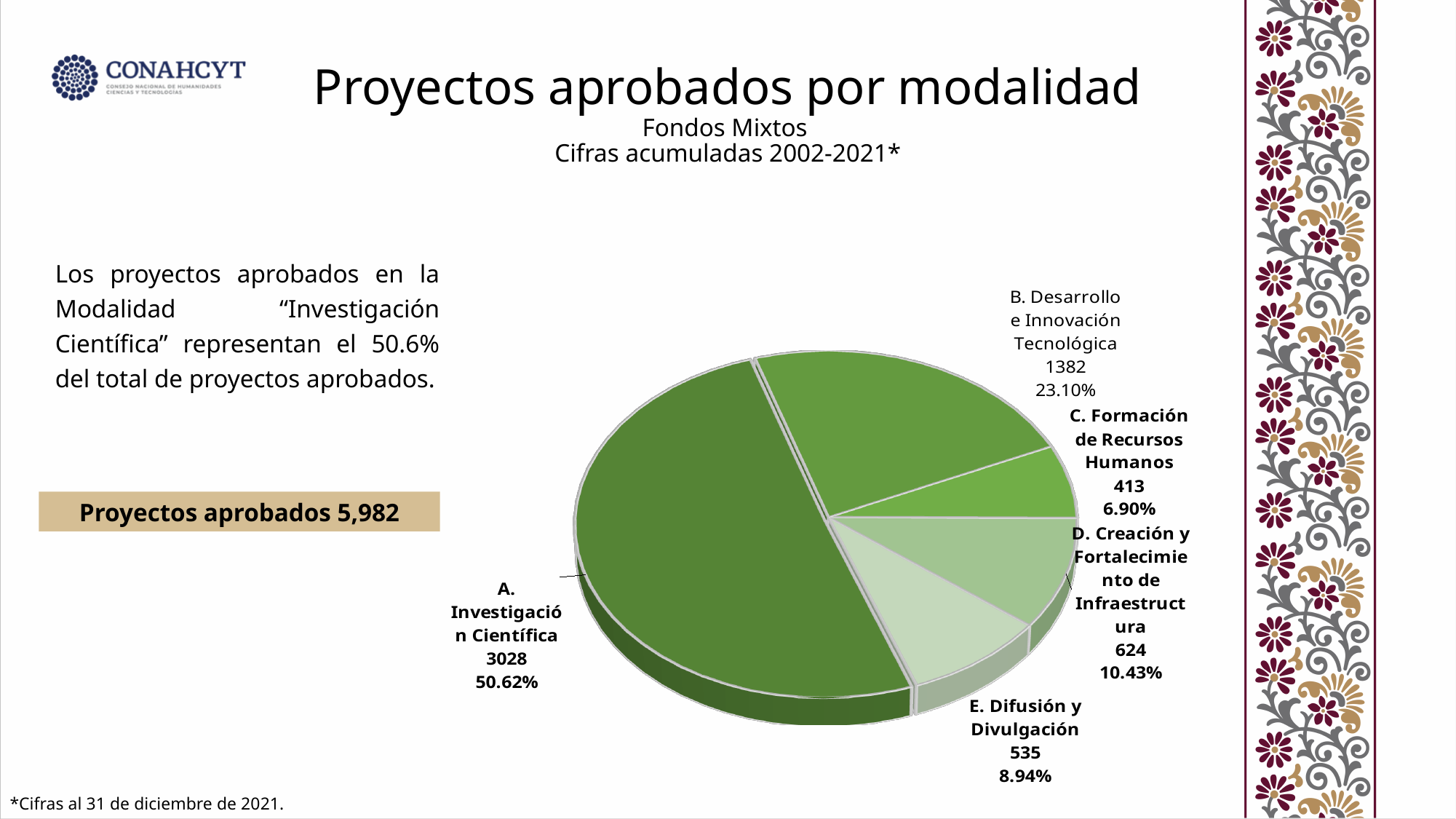
What kind of chart is shown on the slide? Pie chart Which modality has the smallest slice of the pie chart? C. Formación de Recursos Humanos What is the value shown for 'D. Creación y Fortalecimiento de Infraestructura'? 624 Which modality has the largest slice of the pie chart? A. Investigación Científica What percentage share does 'E. Difusión y Divulgación' have? 8.94% What is the title of the chart on the slide? Proyectos aprobados por modalidad What percentage share does 'B. Desarrollo e Innovación Tecnológica' have in the pie chart? 23.10% How many projects were approved in 'C. Formación de Recursos Humanos'? 413 Which has more approved projects: 'D. Creación y Fortalecimiento de Infraestructura' or 'E. Difusión y Divulgación'? D. Creación y Fortalecimiento de Infraestructura What is the difference in approved projects between 'A. Investigación Científica' and 'B. Desarrollo e Innovación Tecnológica'? 1646 How many modalities (slices) are shown in the pie chart? 5 How many projects were approved in the modality 'A. Investigación Científica'? 3028